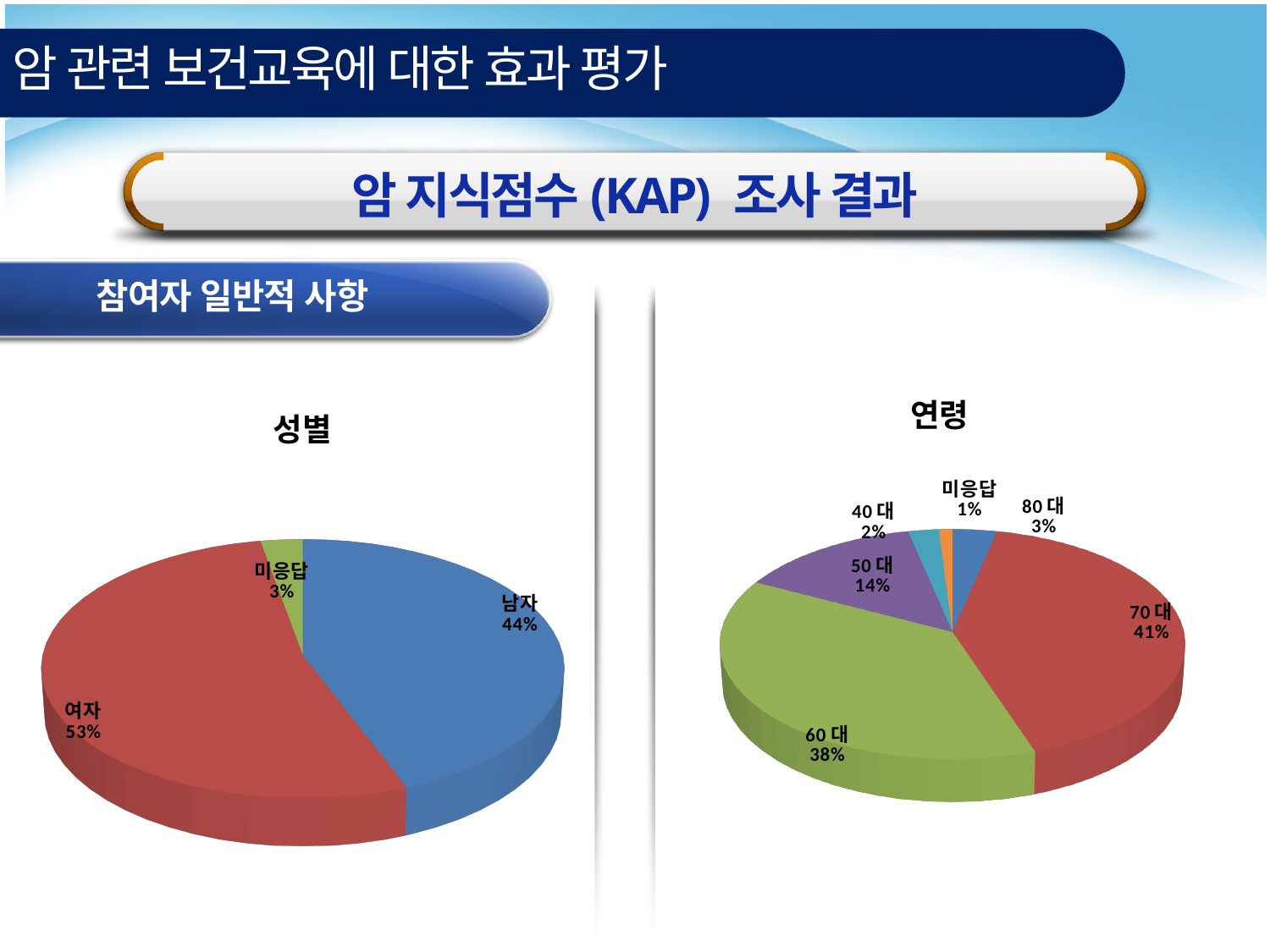
In the 성별 chart, which category has the smallest share? 미응답 In the 연령 chart, what share of participants are 70 대? 41% In the 연령 chart, which age group has the largest share? 70 대 In the 성별 chart, what is the difference in percentage points between 여자 and 남자? 9 In the 연령 chart, what share of participants are 50 대? 14% What kind of chart is the 성별 chart? pie chart In the 성별 chart, how many slices does the pie have? 3 In the 연령 chart, which category has the smallest share? 미응답 In the 연령 chart, how many slices does the pie have? 6 In the 성별 chart, what share of participants are 남자? 44% In the 연령 chart, which is larger, the share for 60 대 or the share for 50 대? 60 대 In the 성별 chart, what share of participants are 여자? 53%